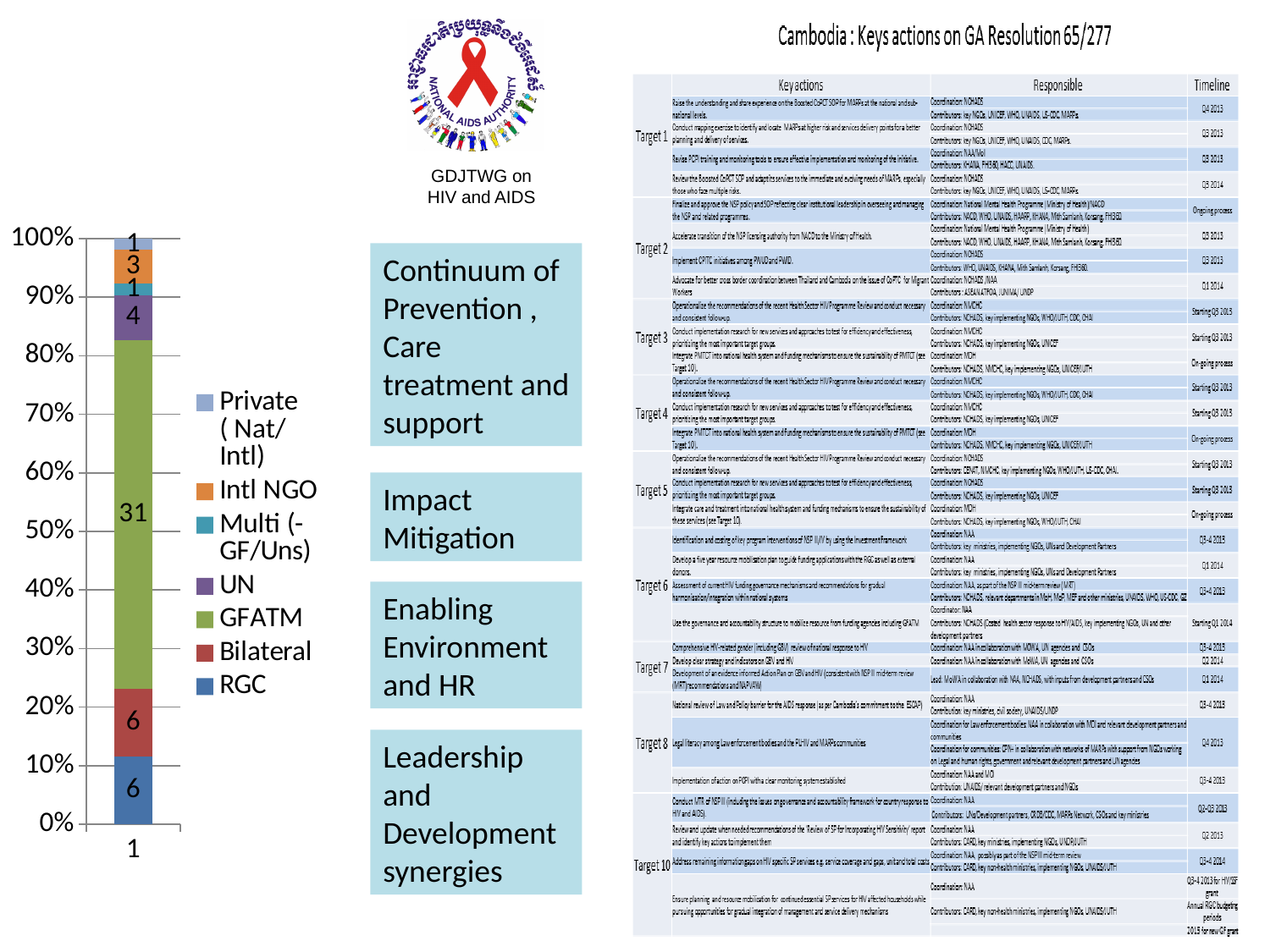
What is the data label for RGC in the stacked bar? 6 What is the data label for Intl NGO in the stacked bar? 3 Which series has the largest value in the stacked bar? GFATM What is the data label for GFATM in the stacked bar? 31 What kind of chart is shown on the left of the slide? stacked bar chart What is the total of all the labelled segments in the stacked bar? 52 What is the data label for UN in the stacked bar? 4 Which series is shown at the bottom of the stacked bar? RGC What is the difference between the GFATM value and the Bilateral value in the stacked bar? 25 How many series does the legend of the bar chart list? 7 Which is larger in the stacked bar, the UN value or the Intl NGO value? UN How many categories are shown on the x axis of the bar chart? 1